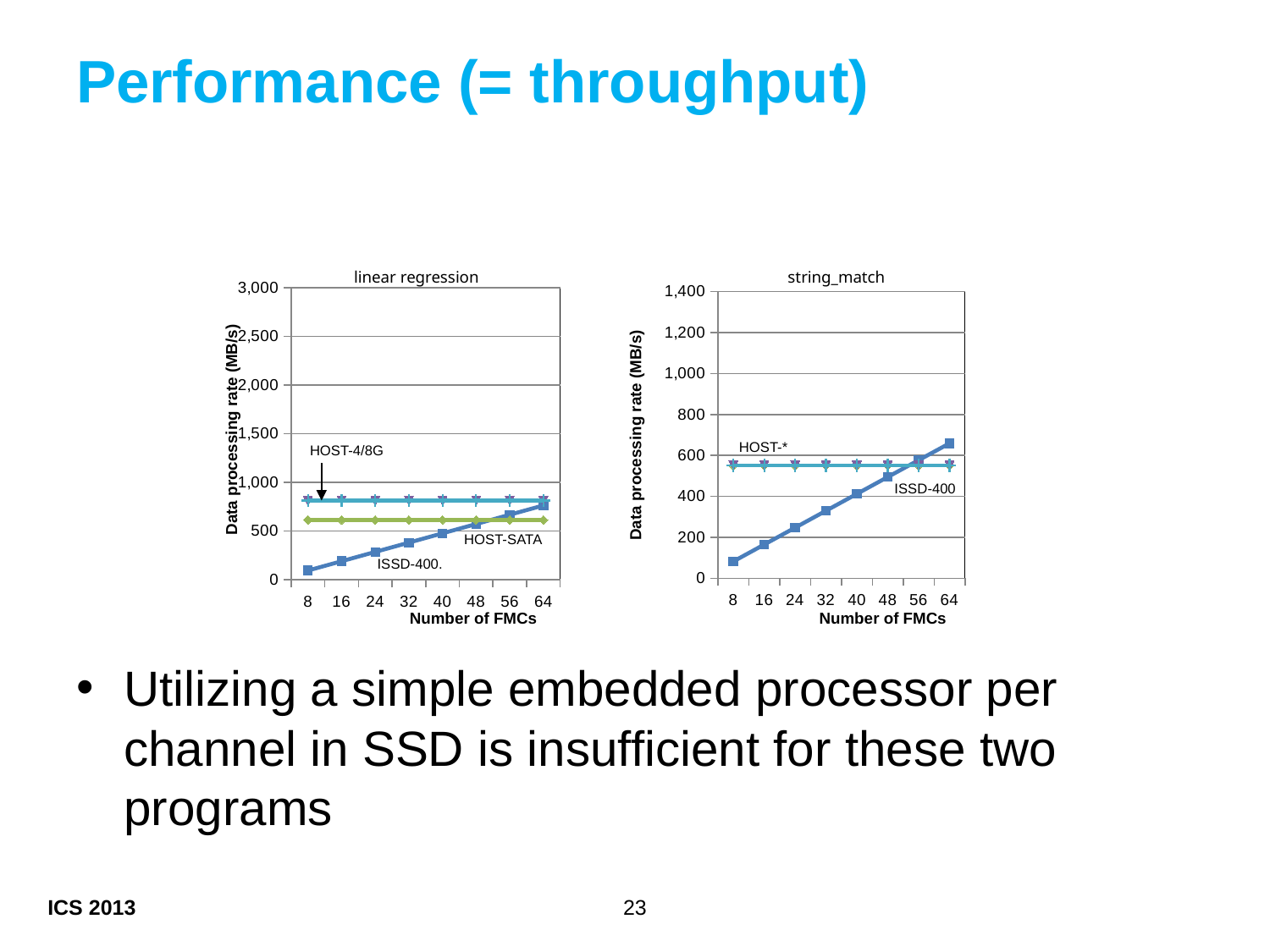
What is the x-axis label of the string_match chart? Number of FMCs In the linear regression chart, does the ISSD-400 series rise or fall as the number of FMCs increases? rises In the linear regression chart, how many Number of FMCs values are plotted along the x axis? 8 In the string_match chart, is the ISSD-400 value at 8 FMCs greater or less than 200? less In the string_match chart, does the HOST-* series rise, fall, or stay flat as the number of FMCs increases? stays flat In the string_match chart, is the ISSD-400 value at 64 FMCs greater or less than 400? greater In the linear regression chart, which series is higher, HOST-4/8G or HOST-SATA? HOST-4/8G In the string_match chart, at 64 FMCs, which series is higher, ISSD-400 or HOST-*? ISSD-400 In the linear regression chart, is the ISSD-400 value at 8 FMCs greater or less than 500? less What kind of chart is the linear regression chart? line chart What is the highest y-axis tick value shown on the string_match chart? 1,400